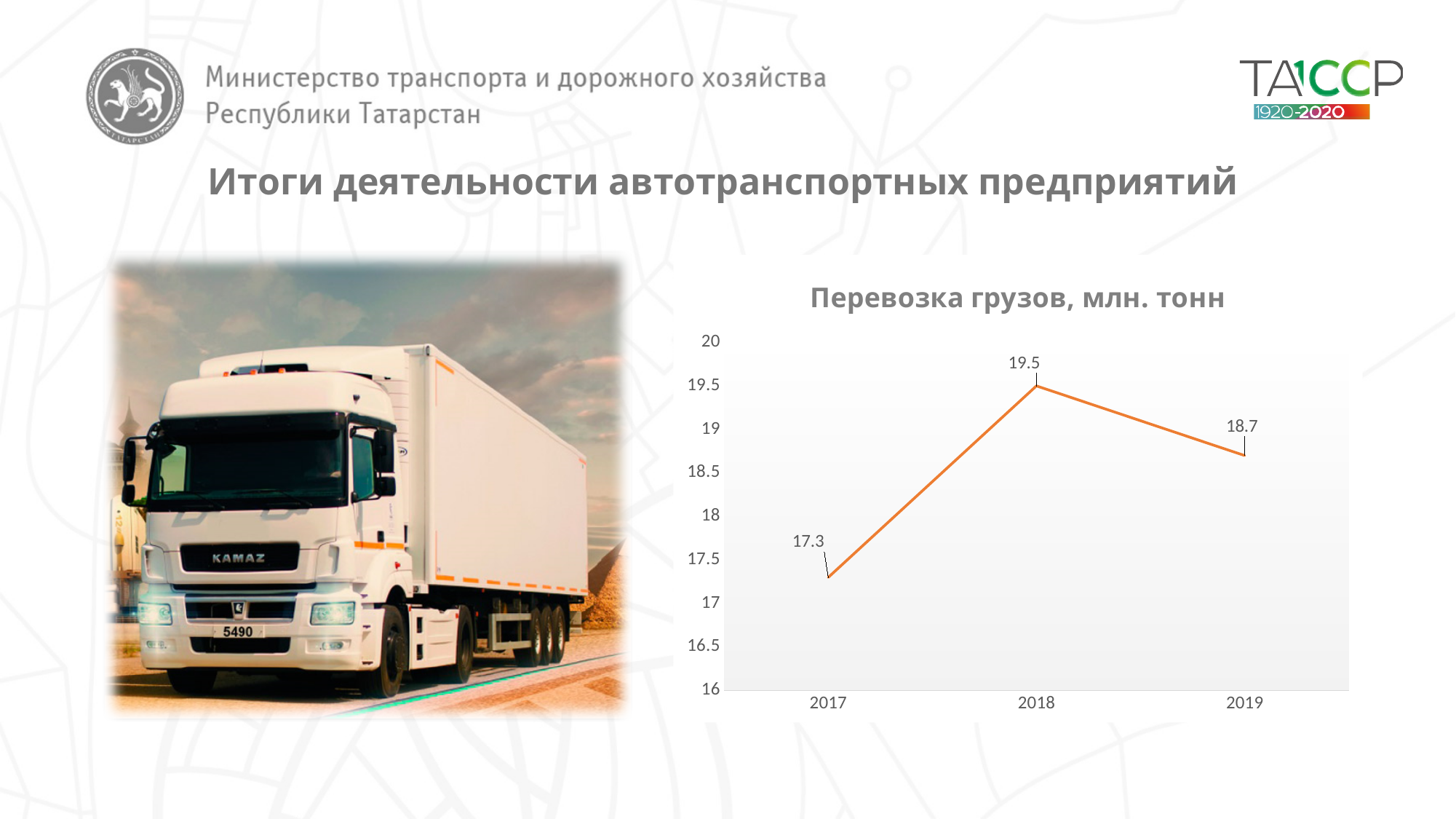
How many years are plotted in the chart 'Перевозка грузов, млн. тонн'? 3 What is the value for 2017 in the chart 'Перевозка грузов, млн. тонн'? 17.3 What is the value for 2018 in the chart 'Перевозка грузов, млн. тонн'? 19.5 Which is larger in the chart 'Перевозка грузов, млн. тонн': the value for 2019 or the value for 2017? 2019 What is the value for 2019 in the chart 'Перевозка грузов, млн. тонн'? 18.7 What is the difference between the 2018 and 2019 values in the chart 'Перевозка грузов, млн. тонн'? 0.8 What kind of chart is 'Перевозка грузов, млн. тонн'? line chart What is the difference between the 2018 and 2017 values in the chart 'Перевозка грузов, млн. тонн'? 2.2 Is the value for 2019 in the chart 'Перевозка грузов, млн. тонн' greater or less than 18? greater Does the value in the chart 'Перевозка грузов, млн. тонн' rise or fall from 2018 to 2019? fall Which year has the highest value in the chart 'Перевозка грузов, млн. тонн'? 2018 Which year has the lowest value in the chart 'Перевозка грузов, млн. тонн'? 2017